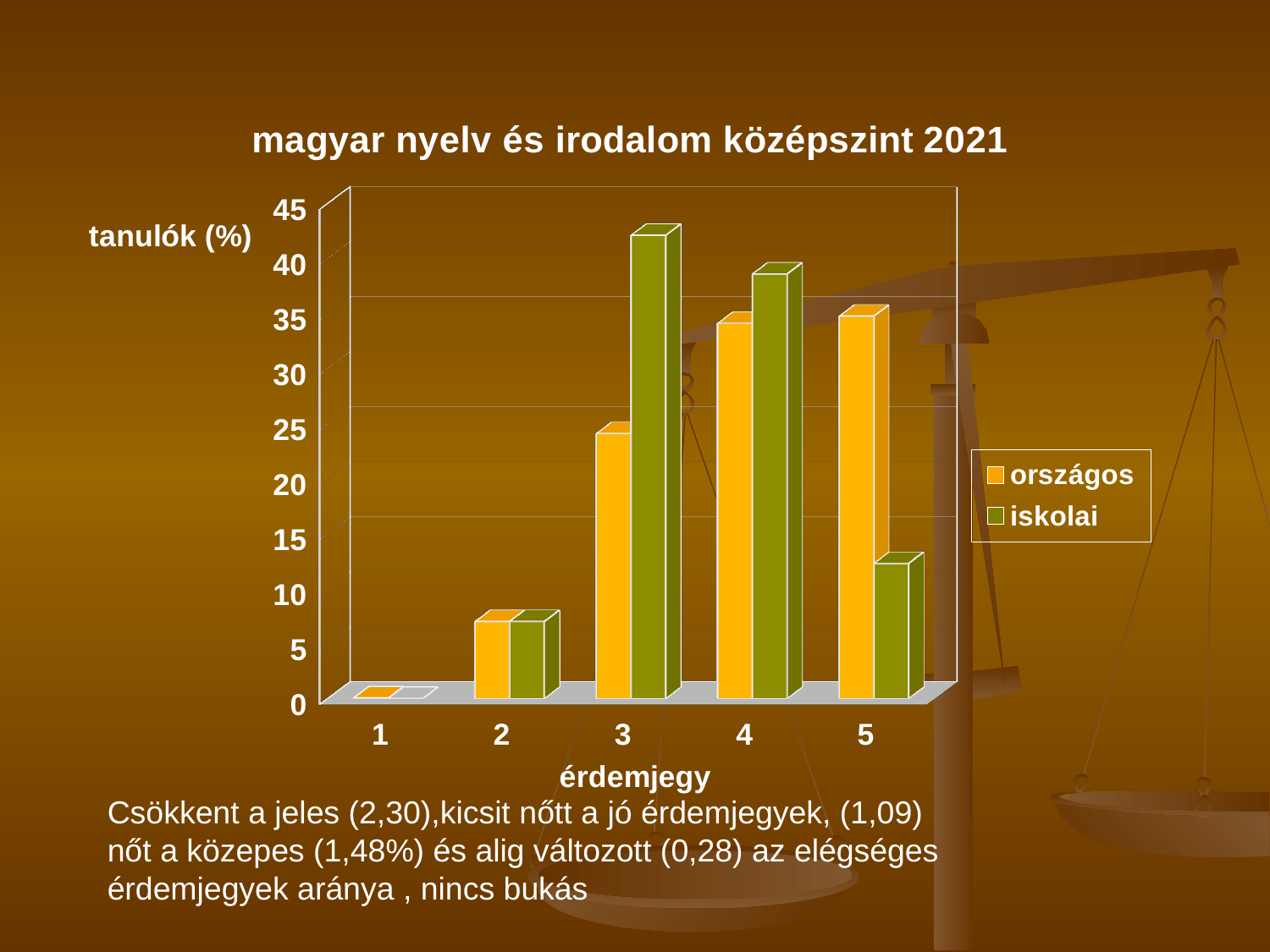
Is the országos value for érdemjegy 3 greater or less than 25? less Which series are listed in the legend? országos, iskolai For érdemjegy 5, which series has the larger value, országos or iskolai? országos What kind of chart is shown on the slide? bar chart What is the title of the chart? magyar nyelv és irodalom középszint 2021 For érdemjegy 3, which series has the larger value, országos or iskolai? iskolai Is the iskolai value for érdemjegy 3 greater or less than 40? greater For which érdemjegy is the iskolai value highest? 3 How many categories (érdemjegy values) are shown on the x axis? 5 Is the iskolai value for érdemjegy 5 greater or less than 15? less How many series does the legend list? 2 For which érdemjegy is the iskolai value lowest? 1